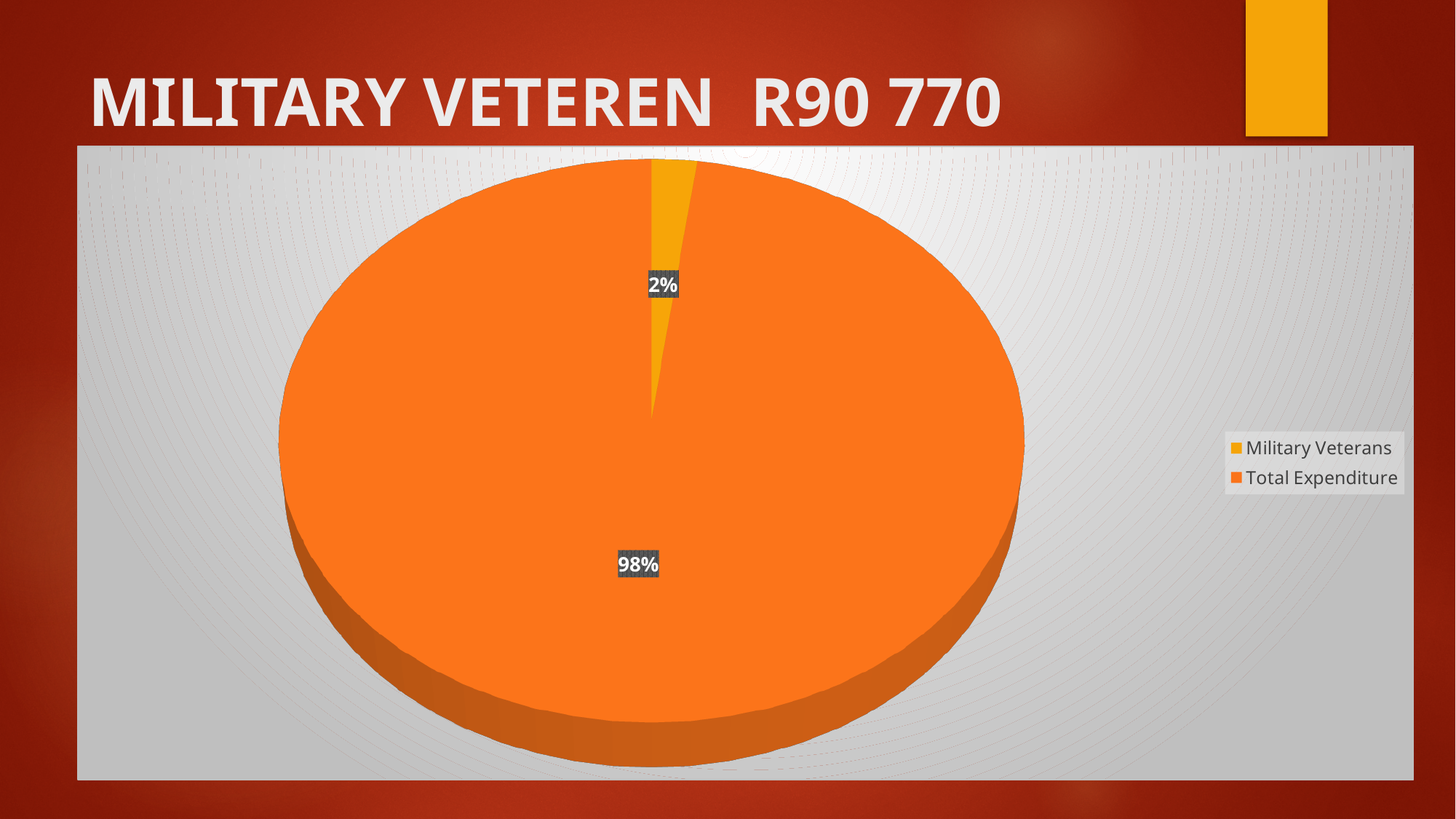
What share of the pie does Total Expenditure represent? 98% What is the difference in percentage points between the Total Expenditure slice and the Military Veterans slice? 96 percentage points Which slice is the smallest? Military Veterans How many entries does the legend list? 2 What kind of chart is shown on the slide? pie chart What colour is the Military Veterans slice? yellow What share of the pie does Military Veterans represent? 2% Which is larger, the Military Veterans slice or the Total Expenditure slice? Total Expenditure How many slices does the pie chart have? 2 What is the title shown above the chart? MILITARY VETEREN R90 770 Which slice is the largest? Total Expenditure